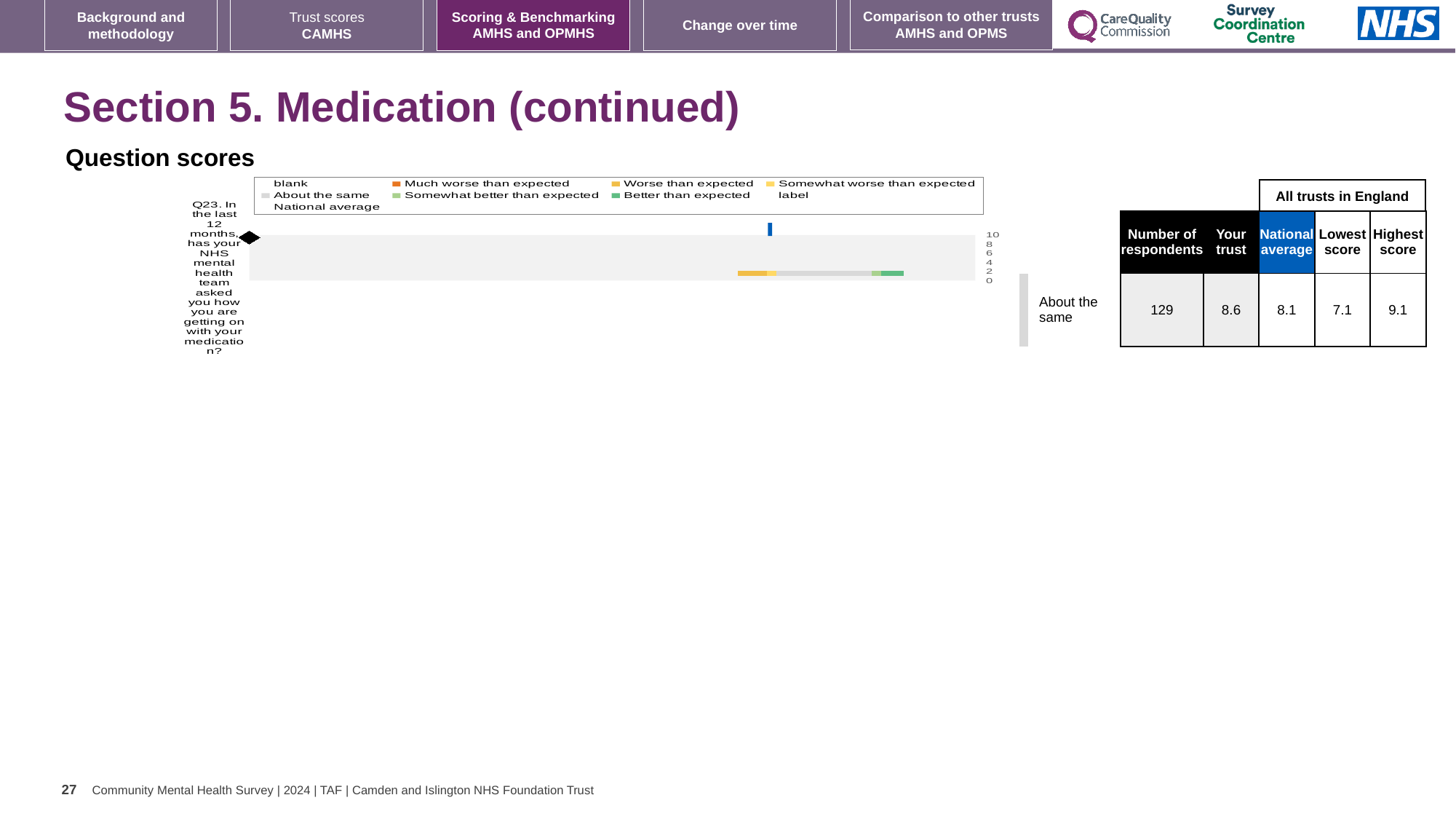
Which benchmark category label is shown next to the Question scores chart for Q23? About the same How many questions (categories) are plotted in the Question scores chart? 1 In the table beside the Question scores chart, what is the Highest score for Q23? 9.1 What kind of chart is shown under 'Question scores'? bar chart What is the difference between the Highest score and the Lowest score for Q23? 2.0 In the table beside the Question scores chart, what is the National average for Q23? 8.1 In the table beside the Question scores chart, what is the 'Your trust' score for Q23? 8.6 Which is larger for Q23, the 'Your trust' score or the National average? Your trust What is the highest value shown on the score axis of the Question scores chart? 10 In the table beside the Question scores chart, what is the Lowest score for Q23? 7.1 Which question is plotted in the Question scores chart? Q23. In the last 12 months, has your NHS mental health team asked you how you are getting on with your medication? In the table beside the Question scores chart, how many respondents answered Q23? 129